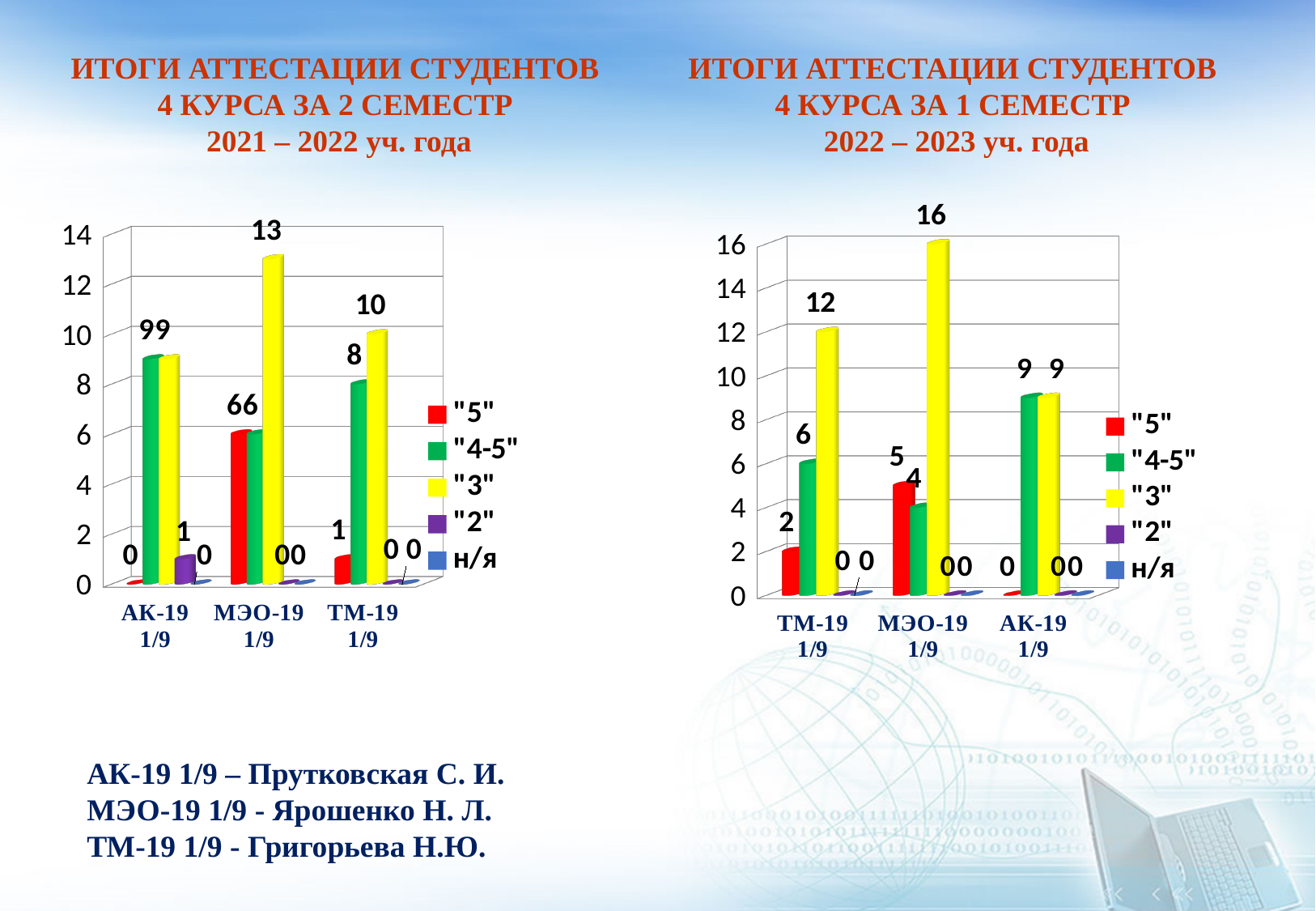
In the right chart (1 семестр 2022–2023), what is the value of the "5" series for ТМ-19 1/9? 2 In the right chart (1 семестр 2022–2023), what is the value of the "3" series for МЭО-19 1/9? 16 In the left chart (2 семестр 2021–2022), what is the value of the "3" series for МЭО-19 1/9? 13 How many groups (categories) are shown on the x axis of the left chart (2 семестр 2021–2022)? 3 In the right chart (1 семестр 2022–2023), what is the difference between the "3" values for МЭО-19 1/9 and ТМ-19 1/9? 4 In the left chart (2 семестр 2021–2022), which is larger for МЭО-19 1/9: the "5" value or the "3" value? "3" In the left chart (2 семестр 2021–2022), what is the value of the "4-5" series for ТМ-19 1/9? 8 What type of chart is the left chart (2 семестр 2021–2022)? Bar chart In the left chart (2 семестр 2021–2022), which group has the highest value in the "3" series? МЭО-19 1/9 How many series does the legend of the right chart (1 семестр 2022–2023) list? 5 In the right chart (1 семестр 2022–2023), what colour represents the "3" series? Yellow In the right chart (1 семестр 2022–2023), which group has the lowest value in the "4-5" series? МЭО-19 1/9